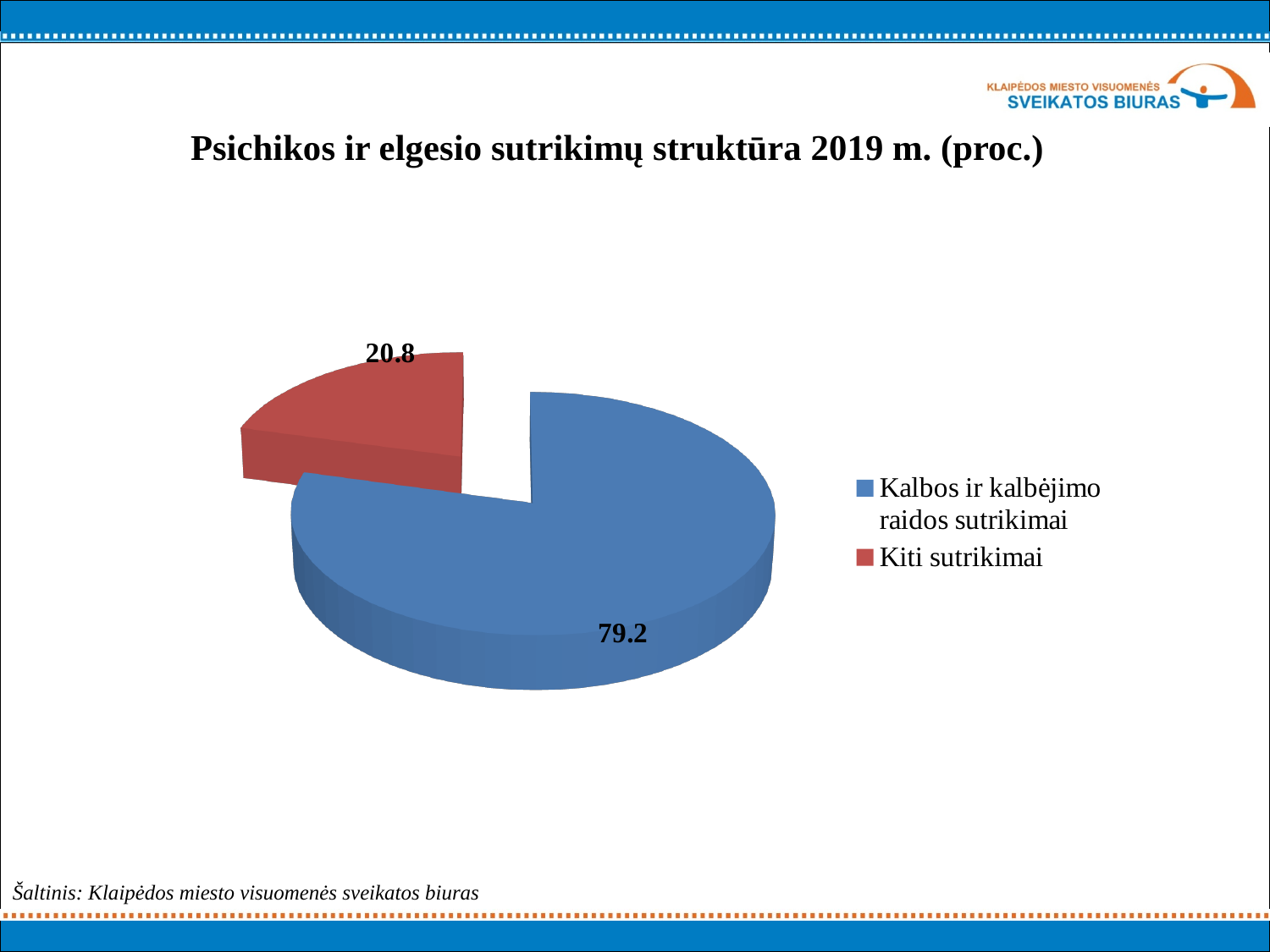
What is the title of the chart? Psichikos ir elgesio sutrikimų struktūra 2019 m. (proc.) Which category has the largest share of the pie? Kalbos ir kalbėjimo raidos sutrikimai How many categories does the pie chart show? 2 Which category has the smallest share of the pie? Kiti sutrikimai What is the difference between the values for Kalbos ir kalbėjimo raidos sutrikimai and Kiti sutrikimai? 58.4 Which is larger, the value for Kalbos ir kalbėjimo raidos sutrikimai or the value for Kiti sutrikimai? Kalbos ir kalbėjimo raidos sutrikimai What is the value for Kiti sutrikimai? 20.8 What kind of chart is shown on the slide? Pie chart What is the value for Kalbos ir kalbėjimo raidos sutrikimai? 79.2 What is the total of the two values shown on the pie chart? 100 What colour is the slice for Kiti sutrikimai? Red